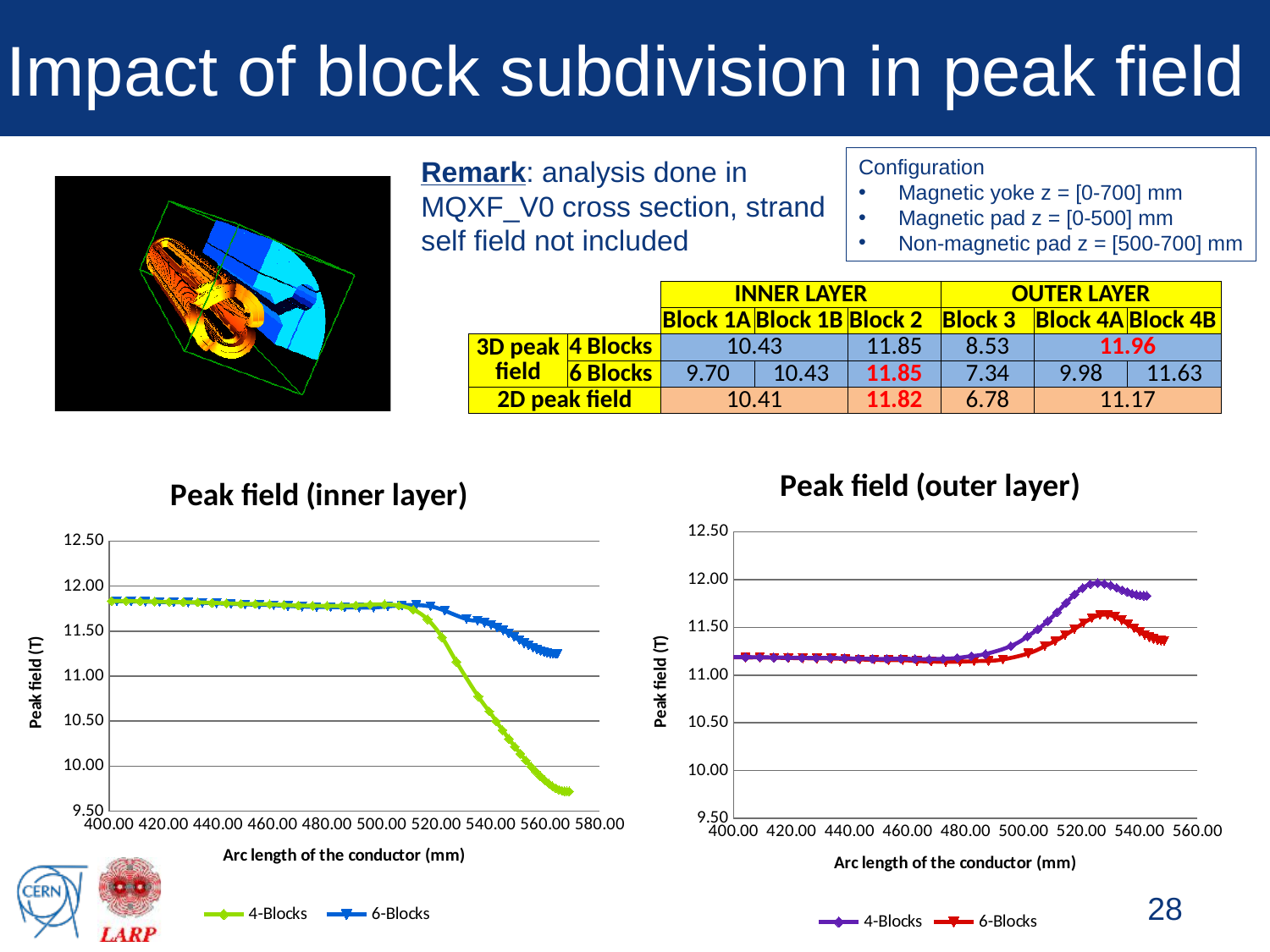
In the 'Peak field (outer layer)' chart, does the 4-Blocks series rise or fall between arc lengths of 480.00 mm and 520.00 mm? rise What are the two series named in the legend of the 'Peak field (outer layer)' chart? 4-Blocks and 6-Blocks In the 'Peak field (inner layer)' chart, which series has the higher value at an arc length of 560.00 mm, 4-Blocks or 6-Blocks? 6-Blocks What kind of chart is the 'Peak field (inner layer)' chart? line chart In the 'Peak field (outer layer)' chart, is the 6-Blocks value at an arc length of 480.00 mm greater or less than 11.50? less In the 'Peak field (inner layer)' chart, is the 4-Blocks value at an arc length of 560.00 mm greater or less than 10.50? less What is the y-axis label of the 'Peak field (outer layer)' chart? Peak field (T) In the 'Peak field (inner layer)' chart, is the 6-Blocks value at an arc length of 560.00 mm greater or less than 11.00? greater How many series does the legend of the 'Peak field (inner layer)' chart list? 2 In the 'Peak field (inner layer)' chart, does the 4-Blocks series rise or fall as the arc length increases beyond 520.00 mm? fall In the 'Peak field (outer layer)' chart, which series reaches the higher peak value, 4-Blocks or 6-Blocks? 4-Blocks